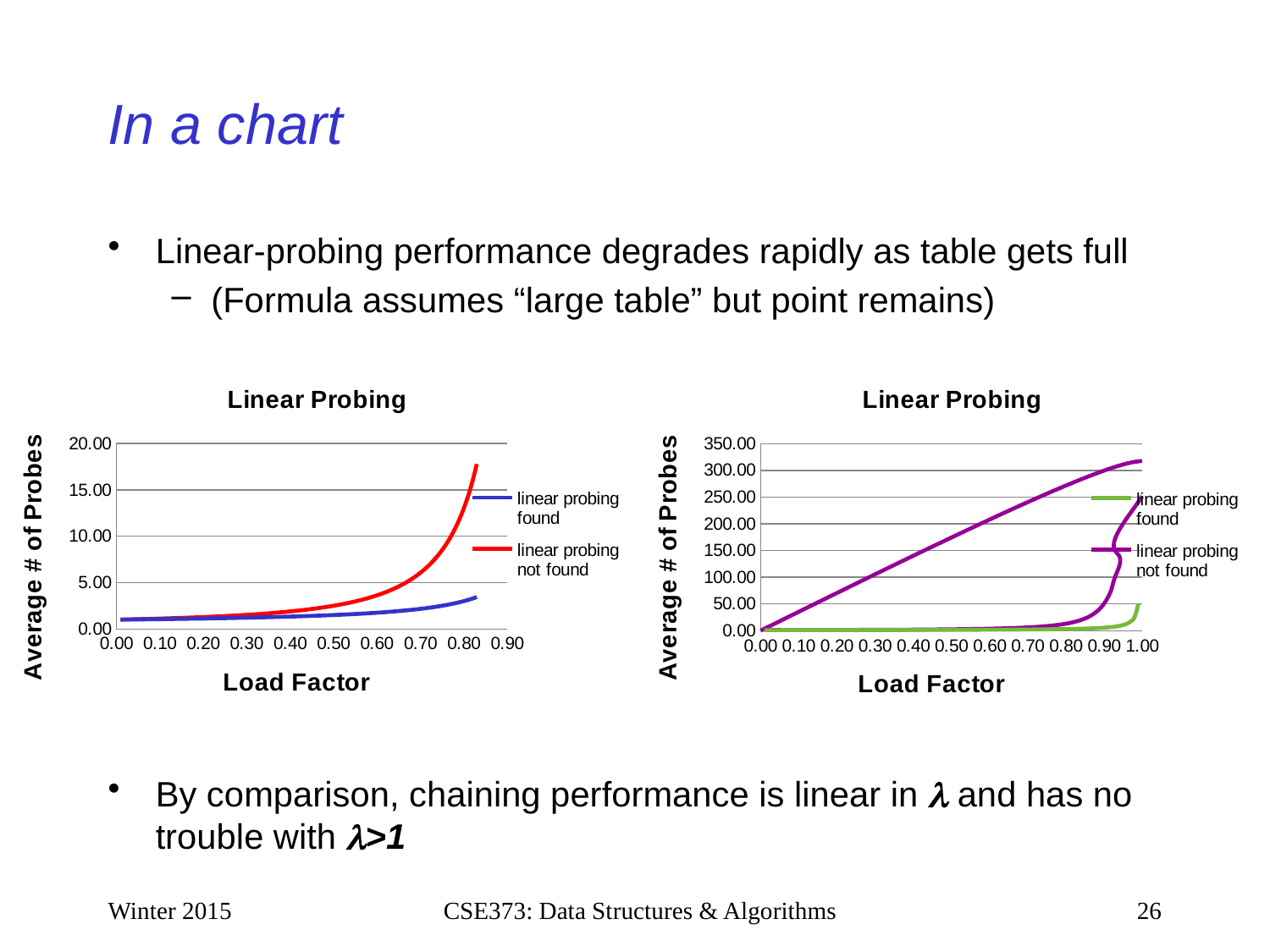
What is the y-axis label of the left chart? Average # of Probes In the right chart, which series has the larger value at load factor 0.50, linear probing found or linear probing not found? linear probing not found How many series does the legend of the left chart list? 2 In the left chart, is the value for linear probing found at load factor 0.80 greater or less than 5.00? less In the left chart, does the linear probing not found series rise or fall as the load factor increases? rise In the right chart, is the value for linear probing found at load factor 0.90 greater or less than 50.00? less What kind of chart is the right chart on the slide? line chart In the left chart, which series has the larger value at load factor 0.80, linear probing found or linear probing not found? linear probing not found In the left chart, is the value for linear probing not found at load factor 0.80 greater or less than 5.00? greater What is the title of the right chart? Linear Probing What kind of chart is the left chart on the slide? line chart